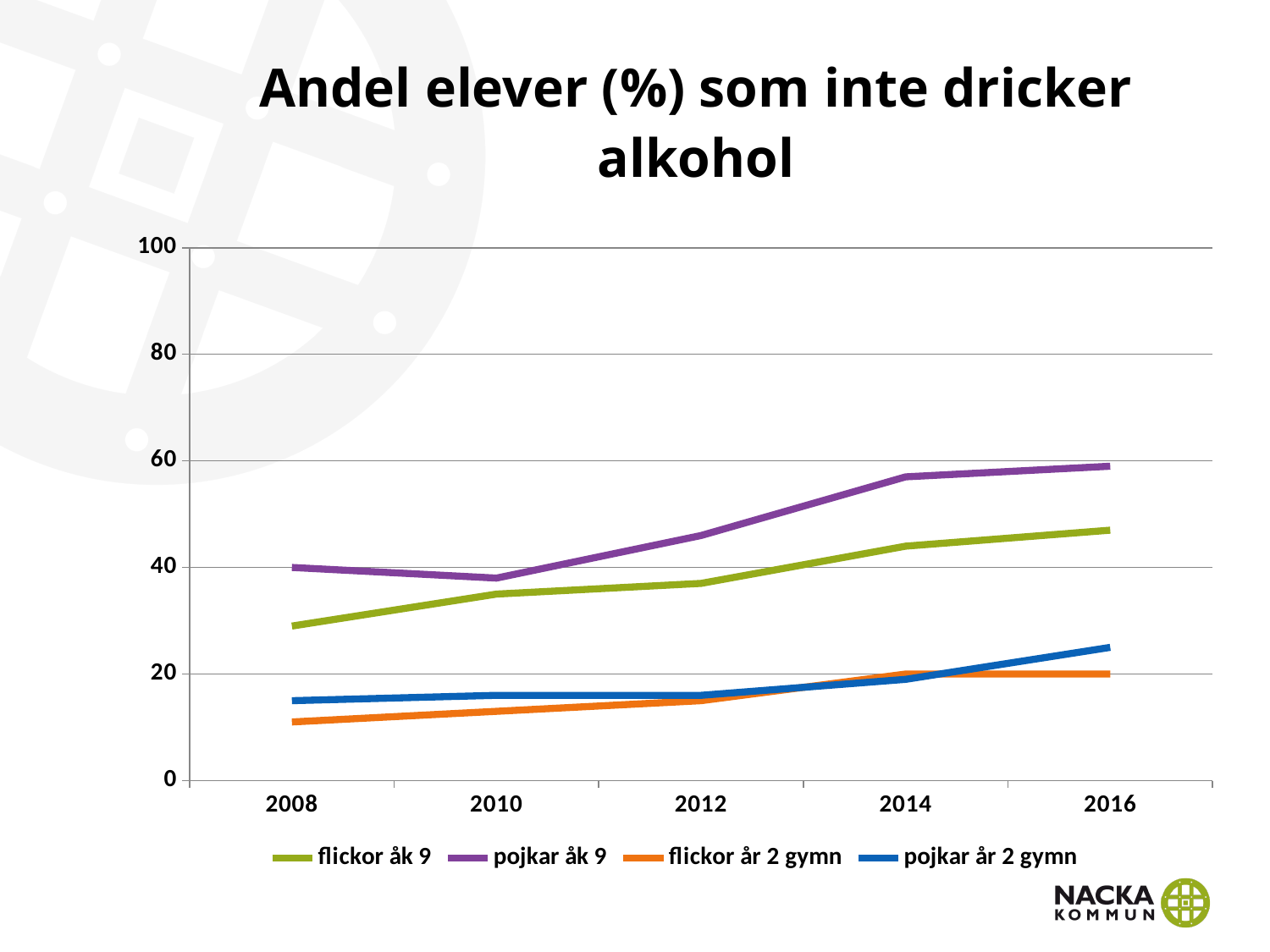
What kind of chart is shown on the slide? line chart Is the value for pojkar åk 9 in 2014 greater or less than 40? greater Which series has the highest value in 2016? pojkar åk 9 How many series does the legend list? 4 Which is larger in 2016, the value for flickor åk 9 or the value for pojkar år 2 gymn? flickor åk 9 How many years are shown on the x axis? 5 Is the value for pojkar år 2 gymn in 2012 greater or less than 20? less Does the value for flickor åk 9 rise or fall from 2008 to 2016? rise Is the value for flickor åk 9 in 2008 greater or less than 40? less What is the title of the chart? Andel elever (%) som inte dricker alkohol Which series has the lowest value in 2008? flickor år 2 gymn